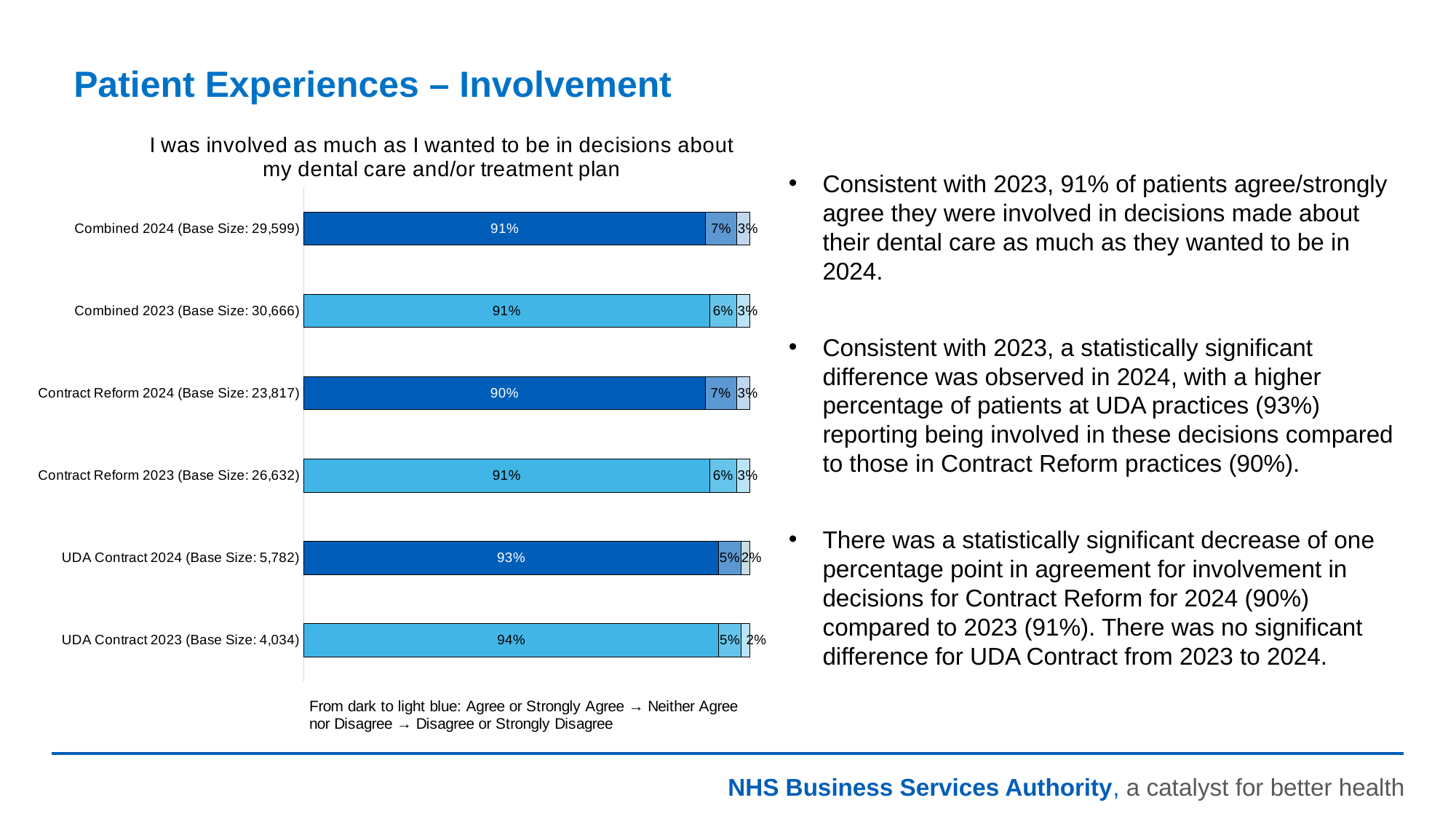
What type of chart is shown on the slide? Stacked bar chart What percentage of UDA Contract 2023 respondents agree or strongly agree? 94% According to the note below the chart, what response does the darkest blue segment represent? Agree or Strongly Agree What is the difference in agree or strongly agree percentage between UDA Contract 2024 and Contract Reform 2024? 3% What percentage of Contract Reform 2024 respondents neither agree nor disagree? 7% Which has a higher agree or strongly agree percentage, UDA Contract 2024 or Combined 2024? UDA Contract 2024 What percentage of UDA Contract 2024 respondents disagree or strongly disagree? 2% How many categories (bars) are shown in the chart? 6 What percentage of Combined 2024 respondents agree or strongly agree they were involved in decisions about their dental care? 91% What is the base size for Combined 2023? 30,666 Which category has the highest percentage of agree or strongly agree? UDA Contract 2023 (Base Size: 4,034) Which category has the lowest percentage of agree or strongly agree? Contract Reform 2024 (Base Size: 23,817)